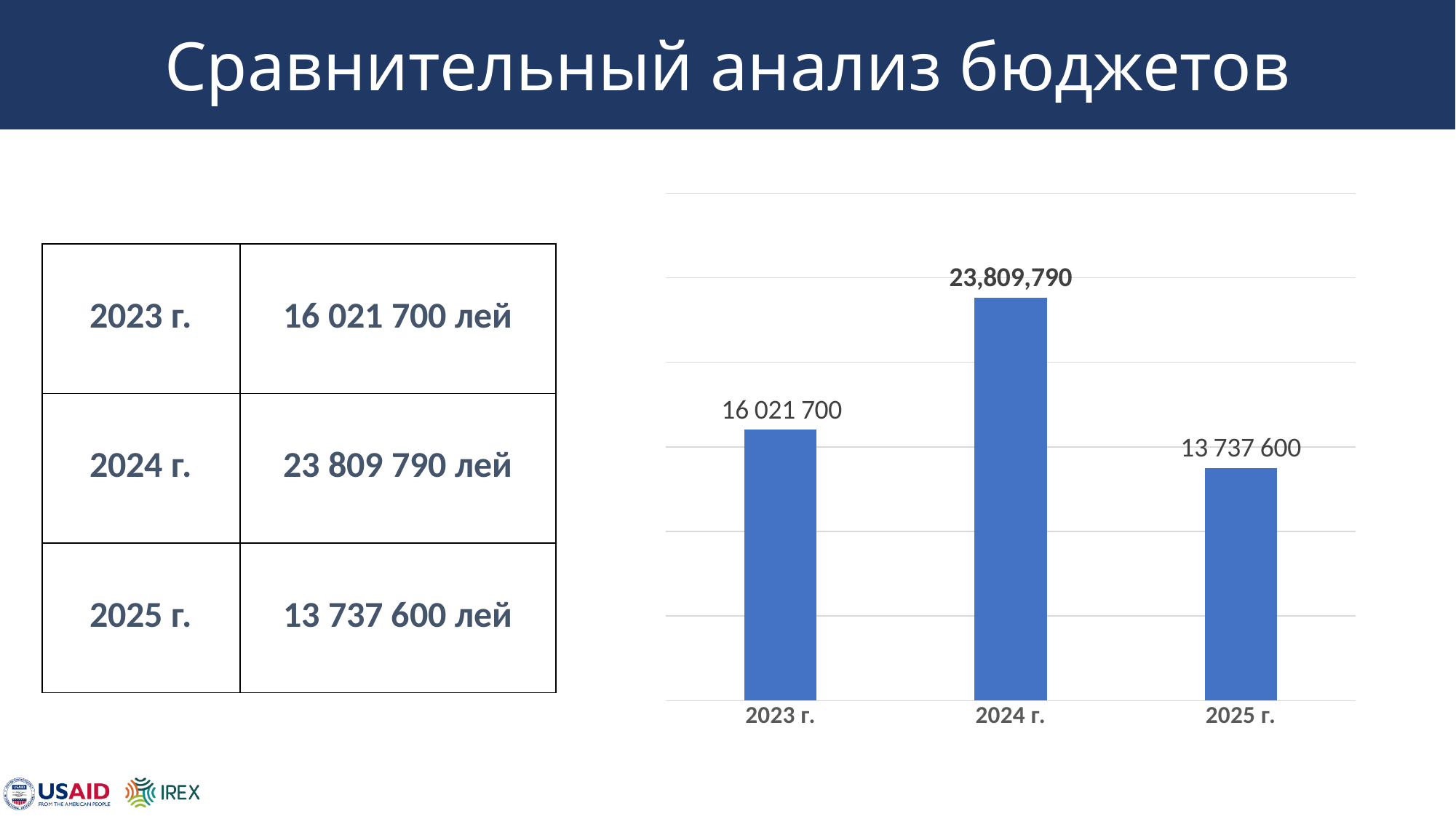
Which is larger in the bar chart, the value for 2023 г. or the value for 2025 г.? 2023 г. Does the value rise or fall from 2024 г. to 2025 г. in the bar chart? Fall What is the value shown for 2023 г. in the bar chart? 16 021 700 What kind of chart is shown on the slide? Bar chart What is the value shown for 2024 г. in the bar chart? 23,809,790 What is the value shown for 2025 г. in the bar chart? 13 737 600 Which year has the highest value in the bar chart? 2024 г. Which year has the lowest value in the bar chart? 2025 г. What colour are the bars in the chart? Blue What is the difference between the values for 2024 г. and 2023 г. in the bar chart? 7 788 090 What is the difference between the values for 2023 г. and 2025 г. in the bar chart? 2 284 100 How many bars are plotted in the chart? 3